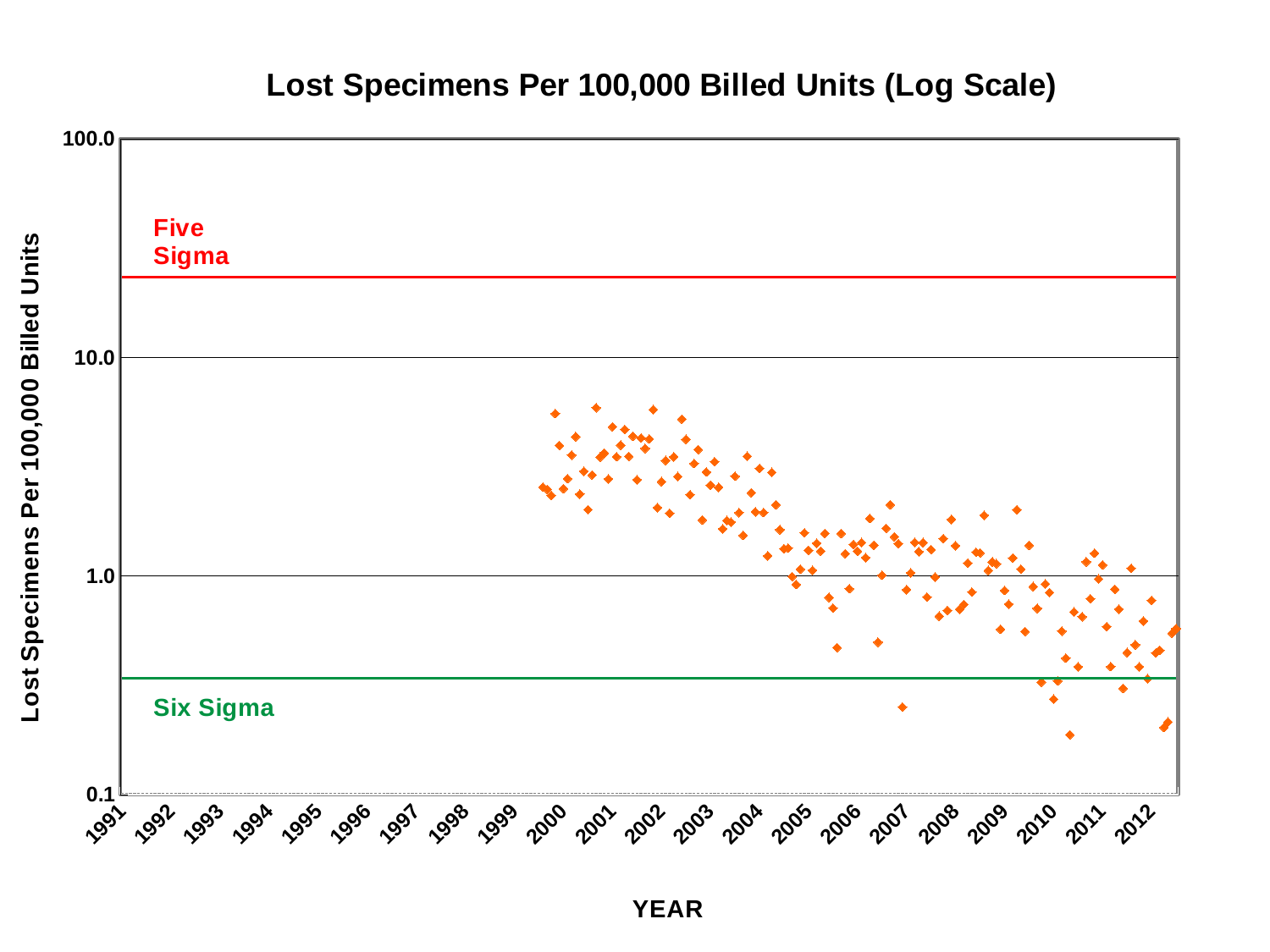
Which reference line is higher on the chart, Five Sigma or Six Sigma? Five Sigma Are the plotted values around 2001 greater or less than 10.0? less Are the plotted values around 2003 greater or less than 1.0? greater Are the plotted values around 2000 greater or less than 1.0? greater What is the title of the chart? Lost Specimens Per 100,000 Billed Units (Log Scale) Do the plotted values generally rise or fall from 2000 to 2012? fall What is the highest value shown on the y axis? 100.0 How many year labels are shown on the x axis? 22 What kind of chart is shown on the slide? scatter chart What is the label of the x axis? YEAR